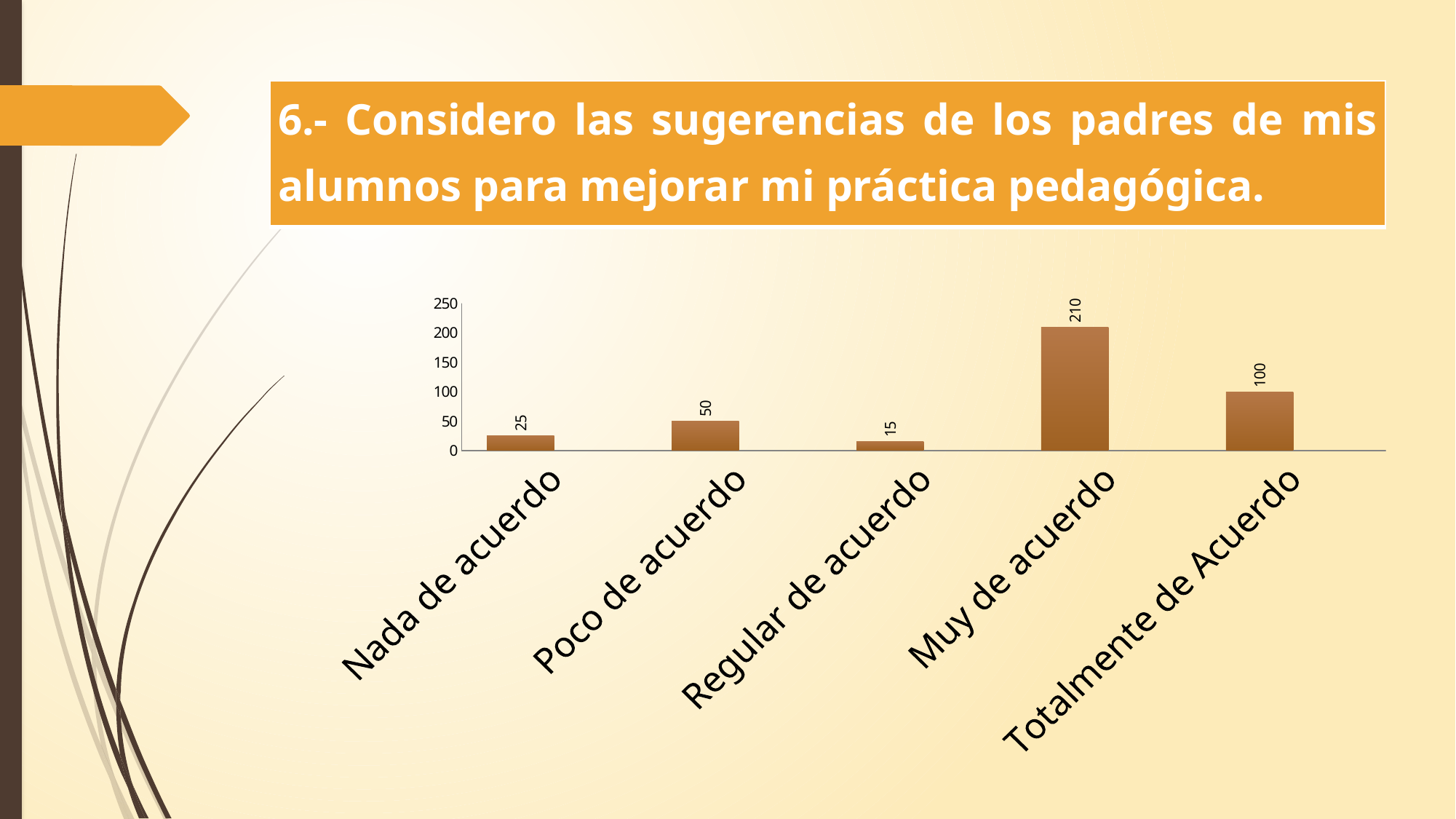
What is the difference between the values for "Muy de acuerdo" and "Totalmente de Acuerdo"? 110 What kind of chart is shown on the slide? bar chart What is the value for "Regular de acuerdo"? 15 What is the value for "Nada de acuerdo"? 25 What is the value for "Totalmente de Acuerdo"? 100 What is the value for "Muy de acuerdo"? 210 Which is larger, the value for "Poco de acuerdo" or the value for "Nada de acuerdo"? Poco de acuerdo Which category has the highest value? Muy de acuerdo What is the highest value shown on the vertical axis? 250 Which category has the lowest value? Regular de acuerdo How many categories are shown on the x axis? 5 Is the value for "Muy de acuerdo" greater or less than 200? greater